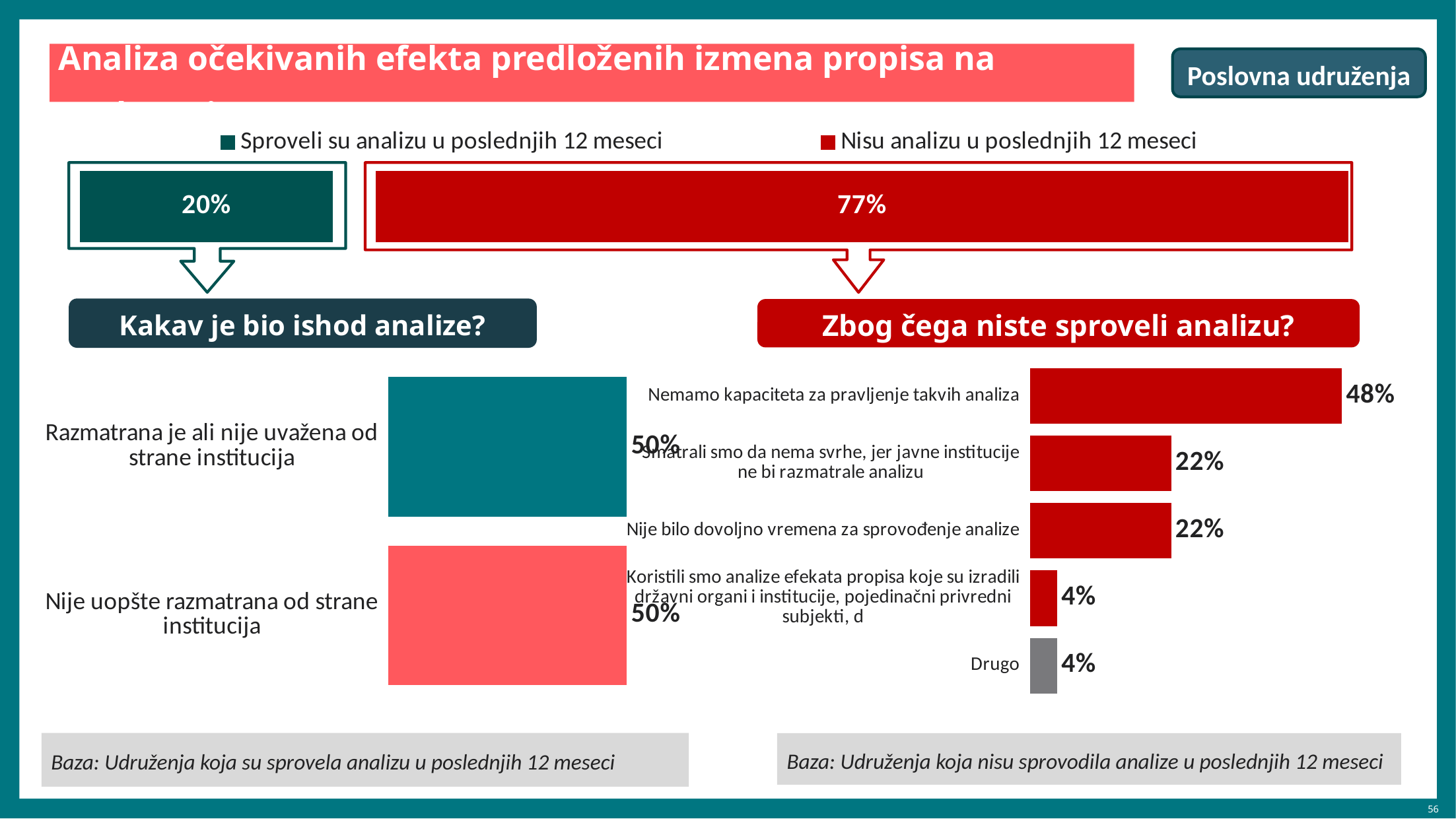
In the chart 'Kakav je bio ishod analize?', what is the value for 'Nije uopšte razmatrana od strane institucija'? 50% In the top bar chart, what percentage of associations conducted an analysis in the last 12 months (Sproveli su analizu u poslednjih 12 meseci)? 20% In the chart 'Zbog čega niste sproveli analizu?', how many categories are shown? 5 In the chart 'Zbog čega niste sproveli analizu?', what is the value for 'Drugo'? 4% In the top bar chart, how many series does the legend list? 2 In the chart 'Zbog čega niste sproveli analizu?', what is the difference between 'Nemamo kapaciteta za pravljenje takvih analiza' and 'Nije bilo dovoljno vremena za sprovođenje analize'? 26% In the top bar chart, what is the value for 'Nisu analizu u poslednjih 12 meseci'? 77% What kind of chart is 'Kakav je bio ishod analize?'? Bar chart In the chart 'Zbog čega niste sproveli analizu?', which category has the highest value? Nemamo kapaciteta za pravljenje takvih analiza In the chart 'Zbog čega niste sproveli analizu?', what is the value for 'Nije bilo dovoljno vremena za sprovođenje analize'? 22% In the chart 'Zbog čega niste sproveli analizu?', what is the value for 'Nemamo kapaciteta za pravljenje takvih analiza'? 48% In the top bar chart, what is the difference between the 'Nisu analizu' value and the 'Sproveli su analizu' value? 57%